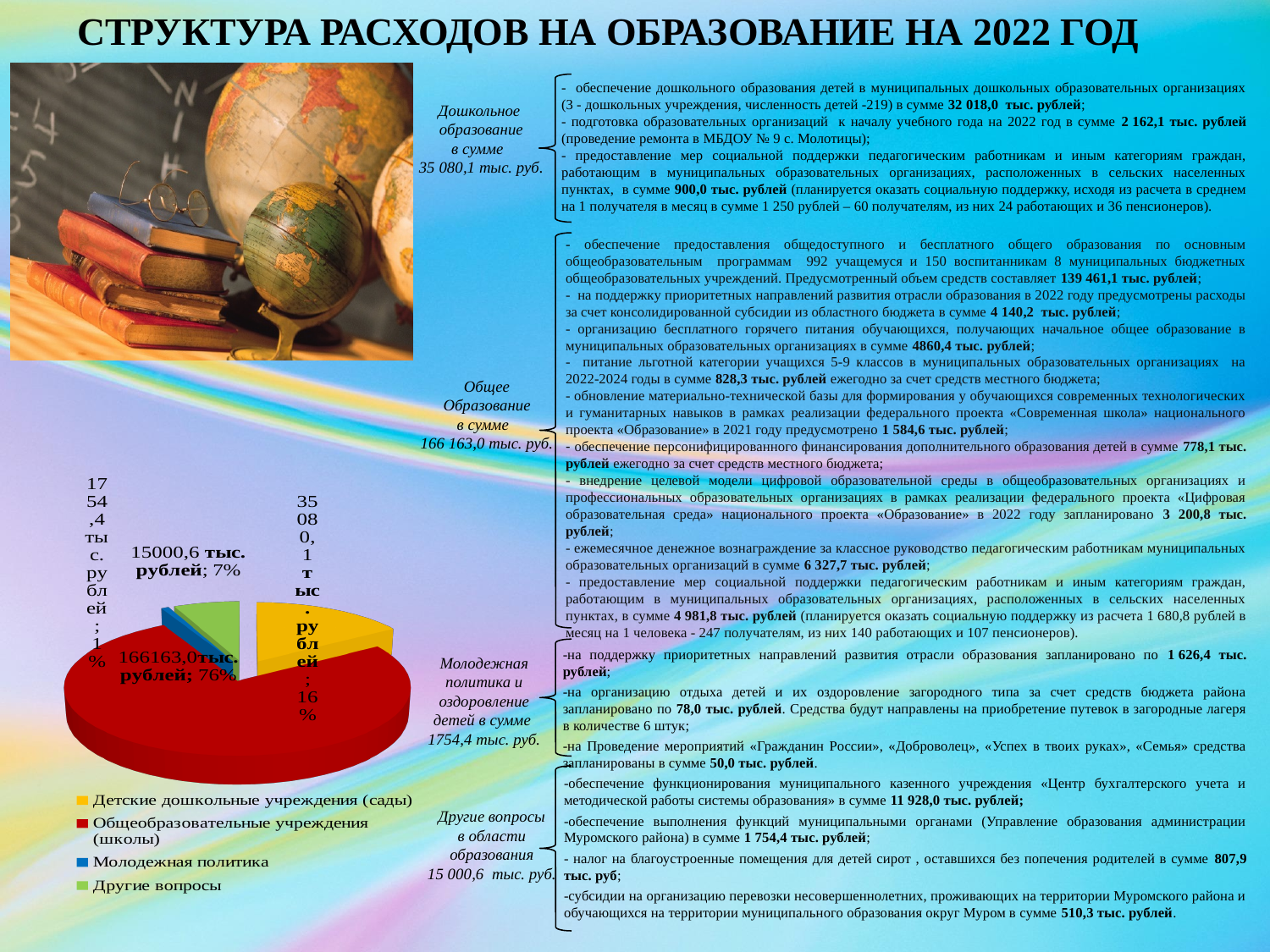
What percentage share of the pie chart is labelled for Детские дошкольные учреждения (сады)? 16% Which category has the largest slice in the pie chart? Общеобразовательные учреждения (школы) What value in тыс. рублей is labelled on the pie chart for Другие вопросы? 15000,6 тыс. рублей What percentage share of the pie chart is labelled for Молодежная политика? 1% Which category has the smallest slice in the pie chart? Молодежная политика What percentage share of the pie chart is labelled for Общеобразовательные учреждения (школы)? 76% Which slice is larger in the pie chart: Детские дошкольные учреждения (сады) or Другие вопросы? Детские дошкольные учреждения (сады) What colour is the slice for Общеобразовательные учреждения (школы) in the pie chart? red How many slices does the pie chart have? 4 How many entries does the legend of the pie chart list? 4 What kind of chart is shown on the slide? pie chart